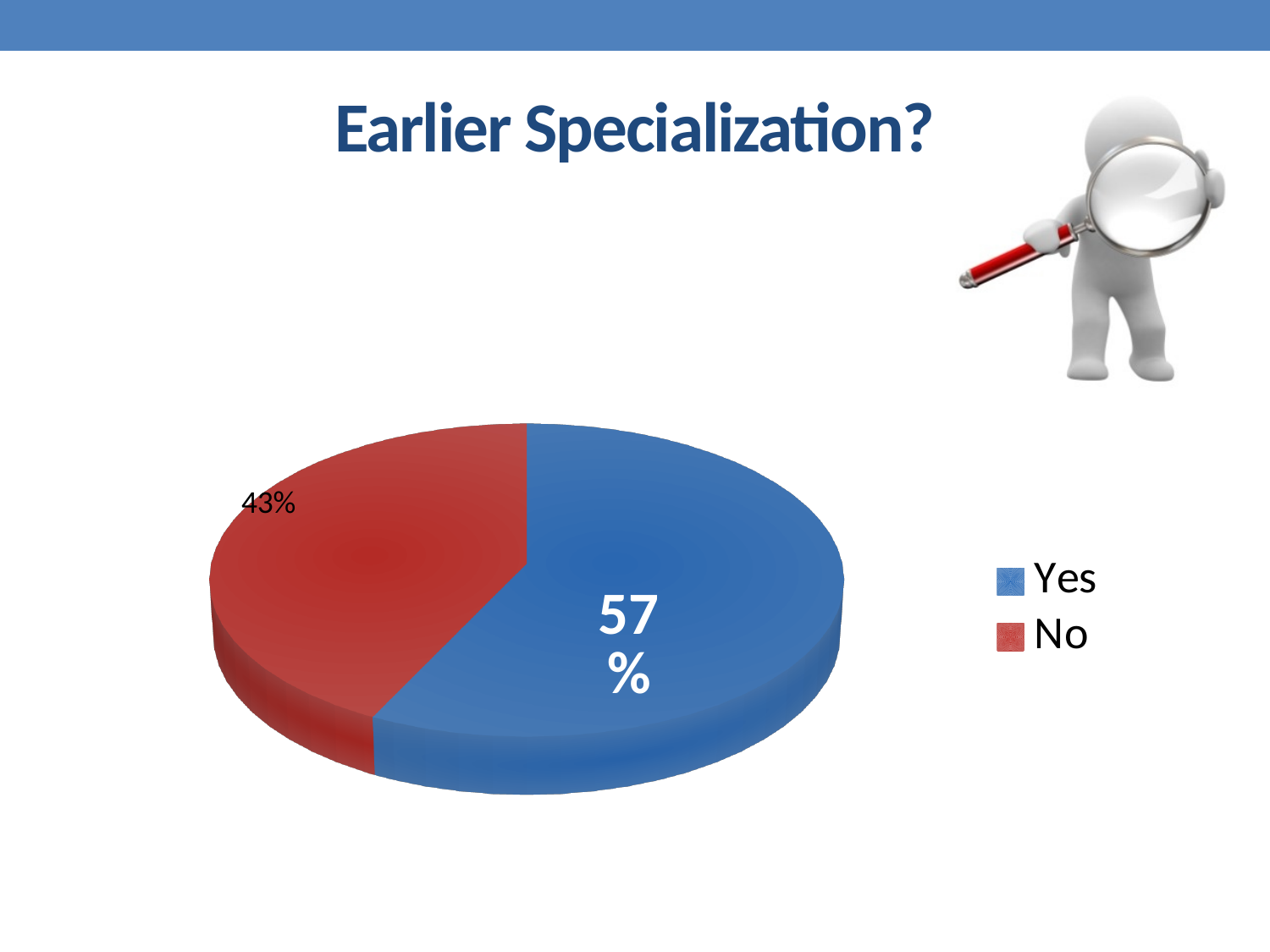
What kind of chart is shown on the slide? Pie chart Which slice is larger, "Yes" or "No"? Yes What is the title of the slide containing the chart? Earlier Specialization? How many entries does the legend list? 2 Which slice of the pie chart is the smallest? No How many slices does the pie chart have? 2 What percentage of the pie chart is labelled "Yes"? 57% Which slice of the pie chart is the largest? Yes What colour is the "No" slice in the pie chart? Red What share of the pie does the "No" slice represent? 43% What percentage of the pie chart is labelled "No"? 43% What is the difference in percentage points between the "Yes" and "No" slices? 14